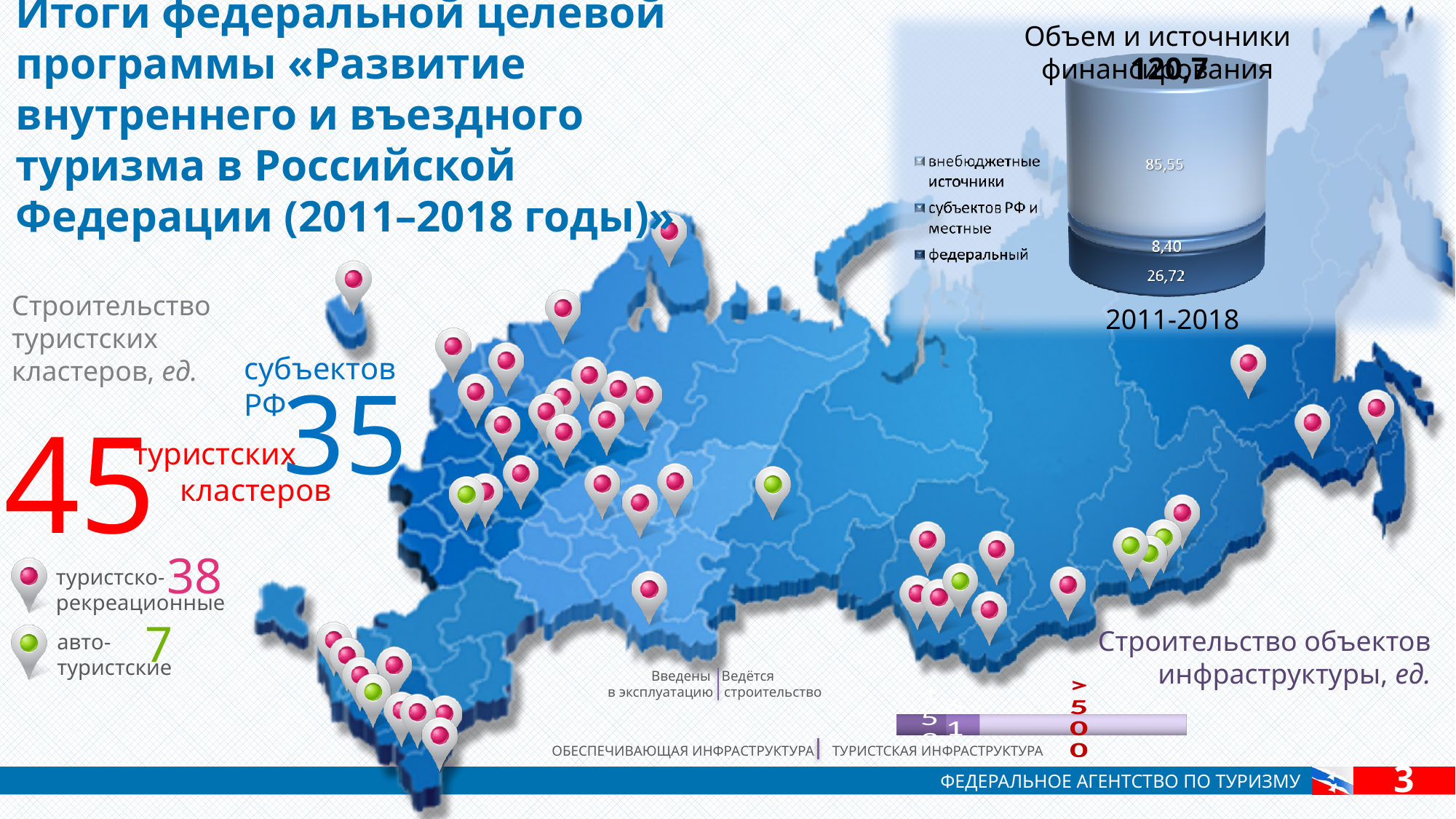
In the chart 'Объем и источники финансирования', what is the value for субъектов РФ и местные? 8,40 In the chart 'Объем и источники финансирования', which funding source has the lowest value? субъектов РФ и местные In the chart 'Объем и источники финансирования', which funding source has the highest value? внебюджетные источники In the chart 'Объем и источники финансирования', what is the value for внебюджетные источники? 85,55 What period label is shown under the bar in the chart 'Объем и источники финансирования'? 2011-2018 How many series does the legend of the chart 'Объем и источники финансирования' list? 3 In the chart 'Объем и источники финансирования', what is the value for федеральный? 26,72 In the chart 'Объем и источники финансирования', what is the difference between федеральный and субъектов РФ и местные? 18,32 What kind of chart is 'Объем и источники финансирования'? stacked bar chart In the chart 'Объем и источники финансирования', what is the total of the stacked bar for 2011-2018? 120,7 In the chart 'Объем и источники финансирования', what is the difference between внебюджетные источники and федеральный? 58,83 In the chart 'Объем и источники финансирования', which is larger: федеральный or субъектов РФ и местные? федеральный